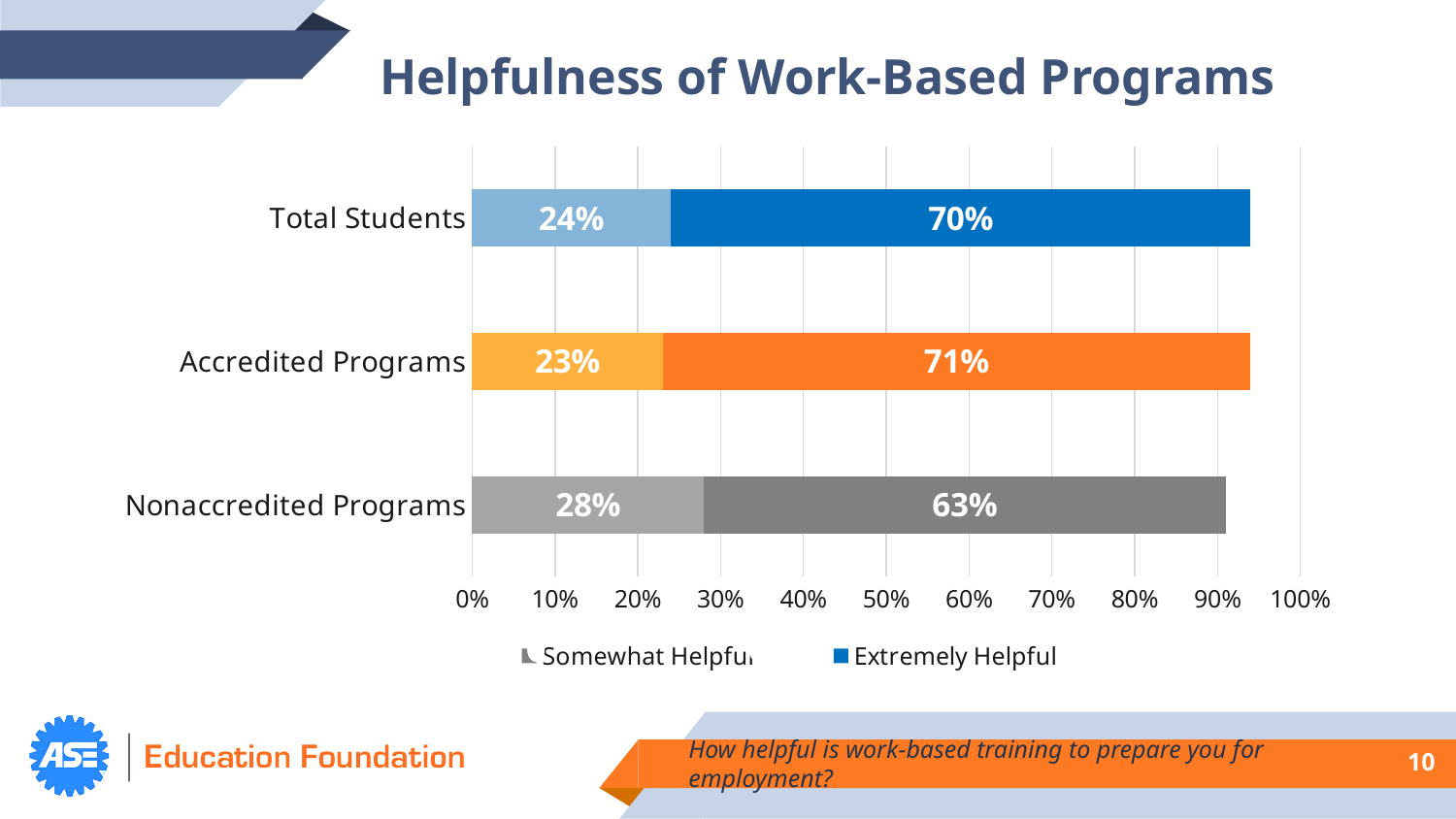
What is the combined total of Somewhat Helpful and Extremely Helpful for Nonaccredited Programs? 91% Which category has the highest Extremely Helpful value? Accredited Programs What is the Somewhat Helpful value for Nonaccredited Programs? 28% What is the Extremely Helpful value for Accredited Programs? 71% How many categories are shown on the chart? 3 What kind of chart is shown on the slide? Stacked bar chart What is the difference between the Extremely Helpful values for Accredited Programs and Nonaccredited Programs? 8% What is the combined total of Somewhat Helpful and Extremely Helpful for Total Students? 94% How many series does the legend list? 2 Which is larger: the Somewhat Helpful value for Nonaccredited Programs or for Accredited Programs? Nonaccredited Programs What percentage of Total Students found work-based programs Extremely Helpful? 70% Which category has the lowest Extremely Helpful value? Nonaccredited Programs